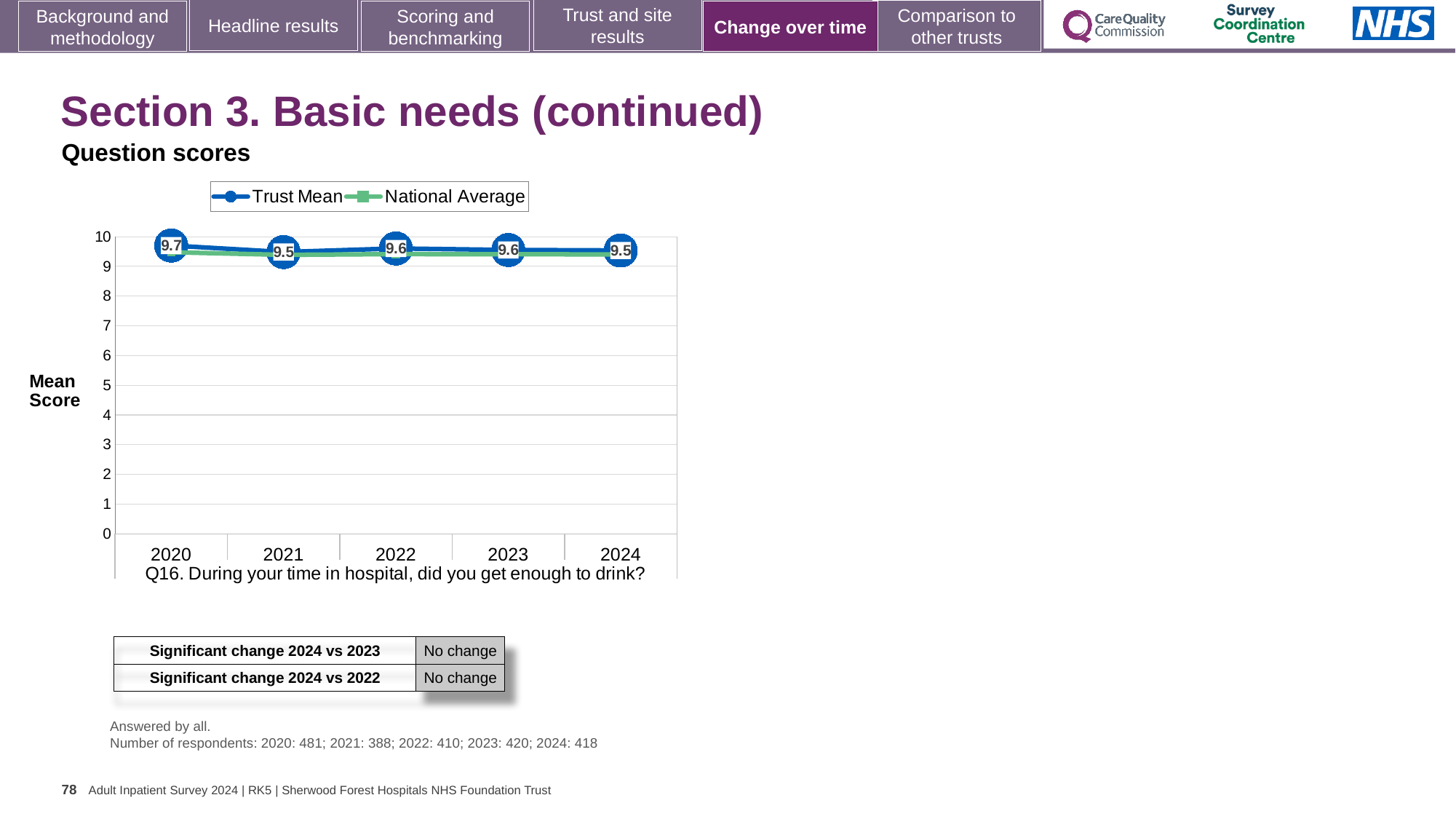
How many series does the legend list? 2 What kind of chart is shown? line chart Is the National Average value for 2022 greater or less than 9? greater In which year is the Trust Mean highest? 2020 What is the Trust Mean value for 2020? 9.7 What is the difference between the Trust Mean in 2020 and in 2021? 0.2 Which is larger, the Trust Mean for 2020 or for 2021? 2020 What is the Trust Mean value for 2022? 9.6 How many years are plotted on the x axis? 5 What is the label on the y axis of the chart? Mean Score What is the Trust Mean value for 2024? 9.5 Does the Trust Mean rise or fall from 2020 to 2024? fall